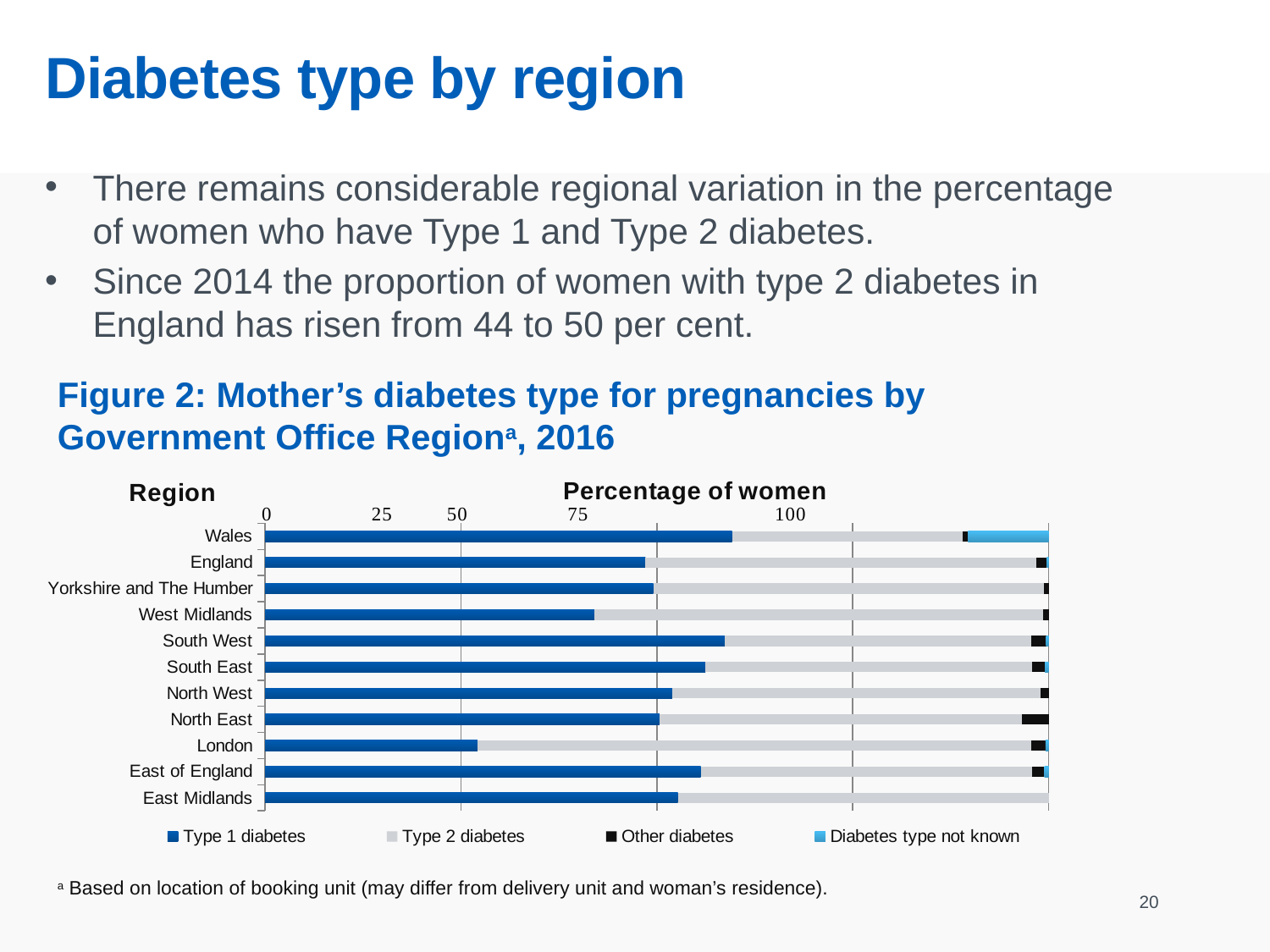
How many regions are plotted in the chart? 11 Which has the larger Type 1 diabetes share, South West or West Midlands? South West Which region has the largest Type 2 diabetes share? London What is the title of the horizontal axis of the chart? Percentage of women How many series does the chart legend list? 4 Which region has the largest 'Diabetes type not known' segment? Wales Which has the larger Type 1 diabetes share, Wales or London? Wales Is the Type 1 diabetes share for Wales greater or less than 50? greater What kind of chart is shown in Figure 2? bar chart Is the Type 1 diabetes share for London greater or less than 75? less Which region has the largest Type 1 diabetes share? Wales Which region has the smallest Type 1 diabetes share? London